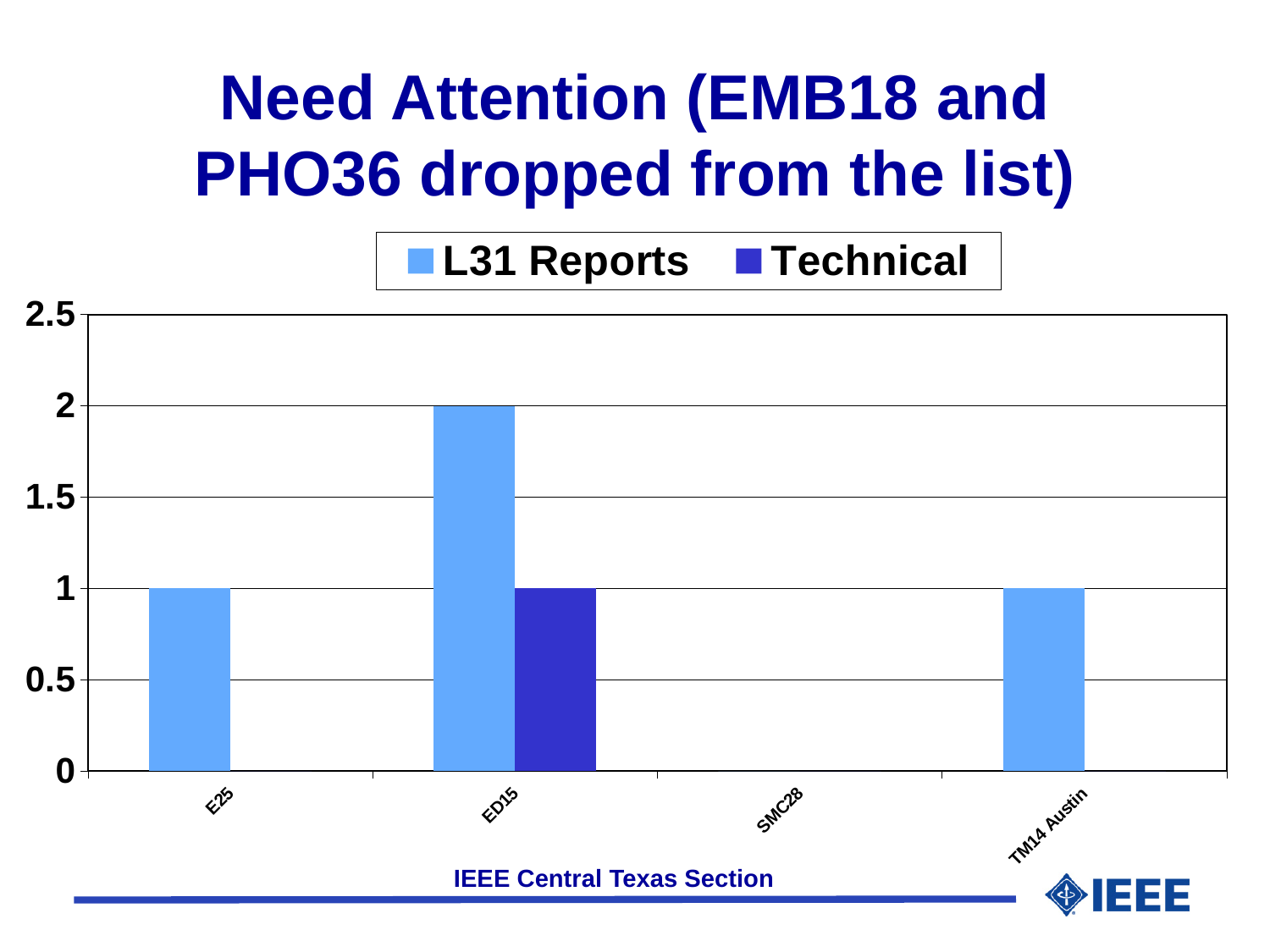
Which is larger for ED15, the L31 Reports value or the Technical value? L31 Reports How many categories are shown on the x axis? 4 What is the L31 Reports value for ED15? 2 Which category has no bars plotted at all? SMC28 Which category has the highest L31 Reports value? ED15 How many series does the legend list? 2 What kind of chart is shown on the slide? bar chart What is the L31 Reports value for TM14 Austin? 1 What is the L31 Reports value for E25? 1 Which series is shown in the darker blue colour? Technical What is the difference between the L31 Reports value and the Technical value for ED15? 1 What is the Technical value for ED15? 1